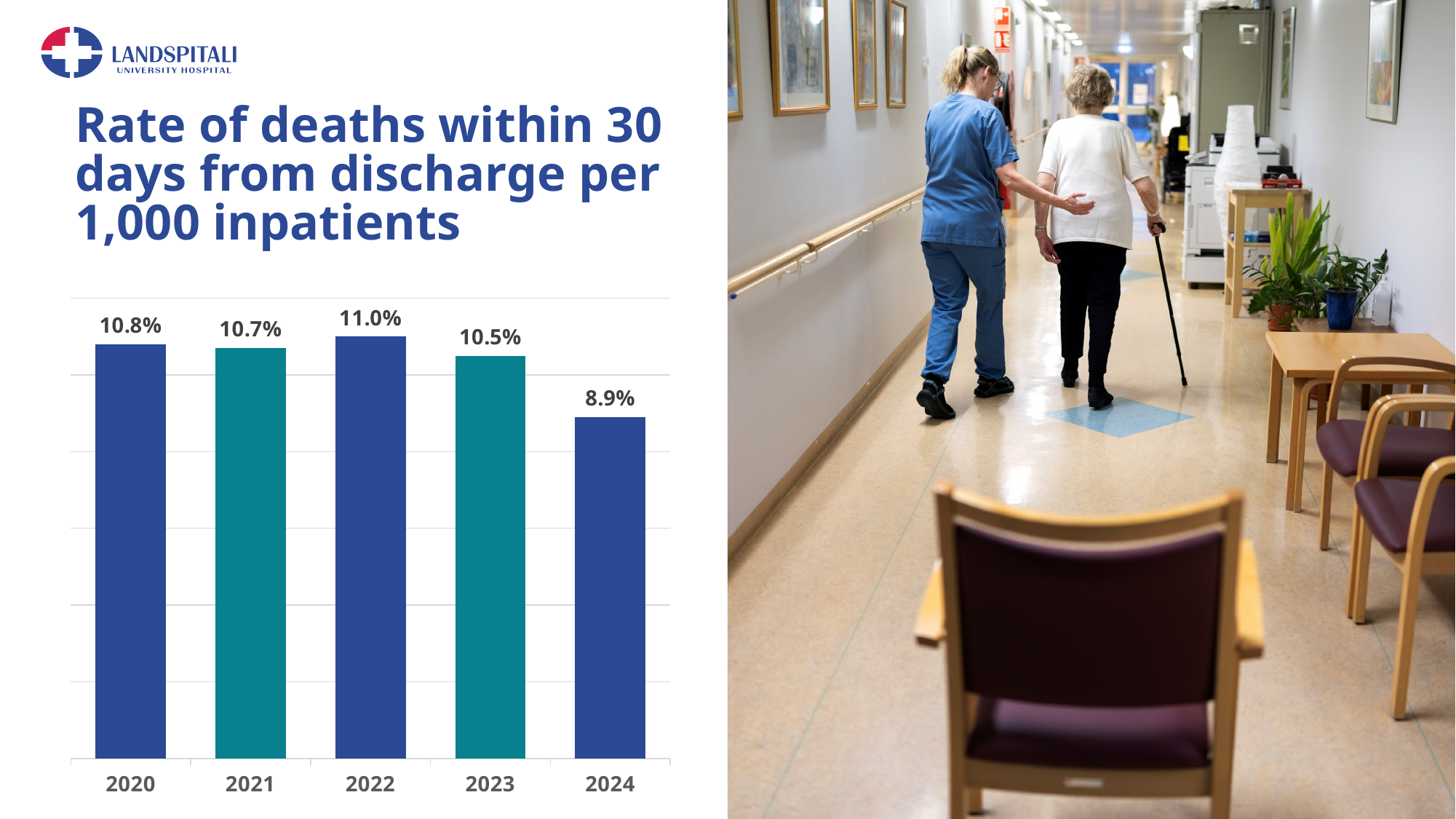
What is the title of the chart? Rate of deaths within 30 days from discharge per 1,000 inpatients Does the rate rise or fall from 2022 to 2024? Fall How many years are shown on the x axis? 5 What kind of chart is shown on the slide? Bar chart Which is larger, the value for 2023 or the value for 2024? 2023 What is the value shown for 2022? 11.0% What is the difference between the 2020 value and the 2021 value? 0.1% Which year has the lowest rate? 2024 What is the value shown for 2024? 8.9% Which year has the highest rate? 2022 What is the rate of deaths within 30 days from discharge per 1,000 inpatients for 2020? 10.8% What is the difference between the 2022 value and the 2024 value? 2.1%